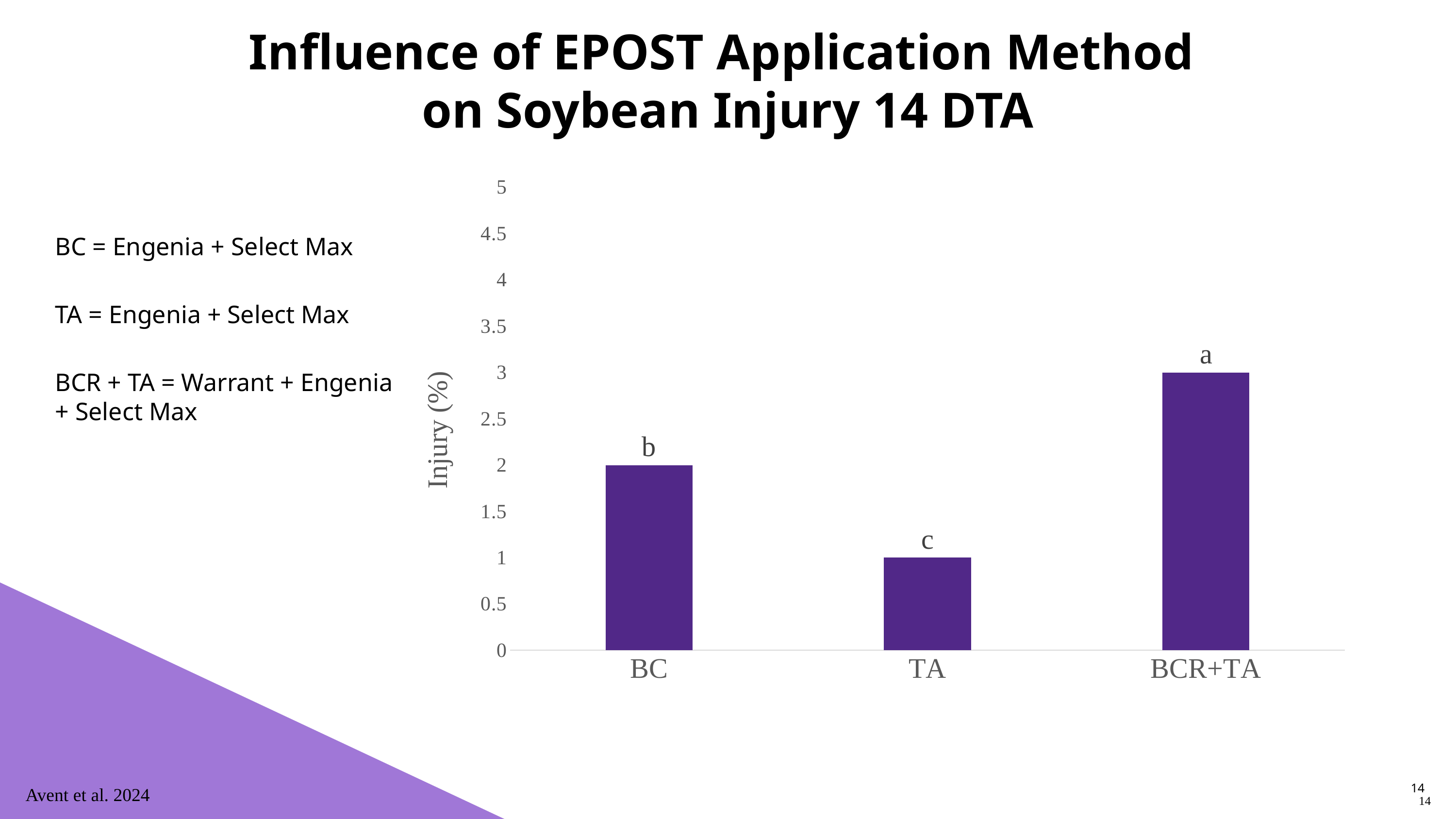
What is the injury (%) value for TA? 1 How many categories are plotted on the x axis? 3 Is the value for BCR+TA greater or less than 2.5? greater Which has a larger injury (%) value, BC or TA? BC What is the label on the y axis? Injury (%) What is the injury (%) value for BC? 2 What is the injury (%) value for BCR+TA? 3 What type of chart is shown on the slide? bar chart Which category has the lowest injury (%)? TA What is the difference in injury (%) between BCR+TA and TA? 2 What letter is printed above the BCR+TA bar? a Which category has the highest injury (%)? BCR+TA